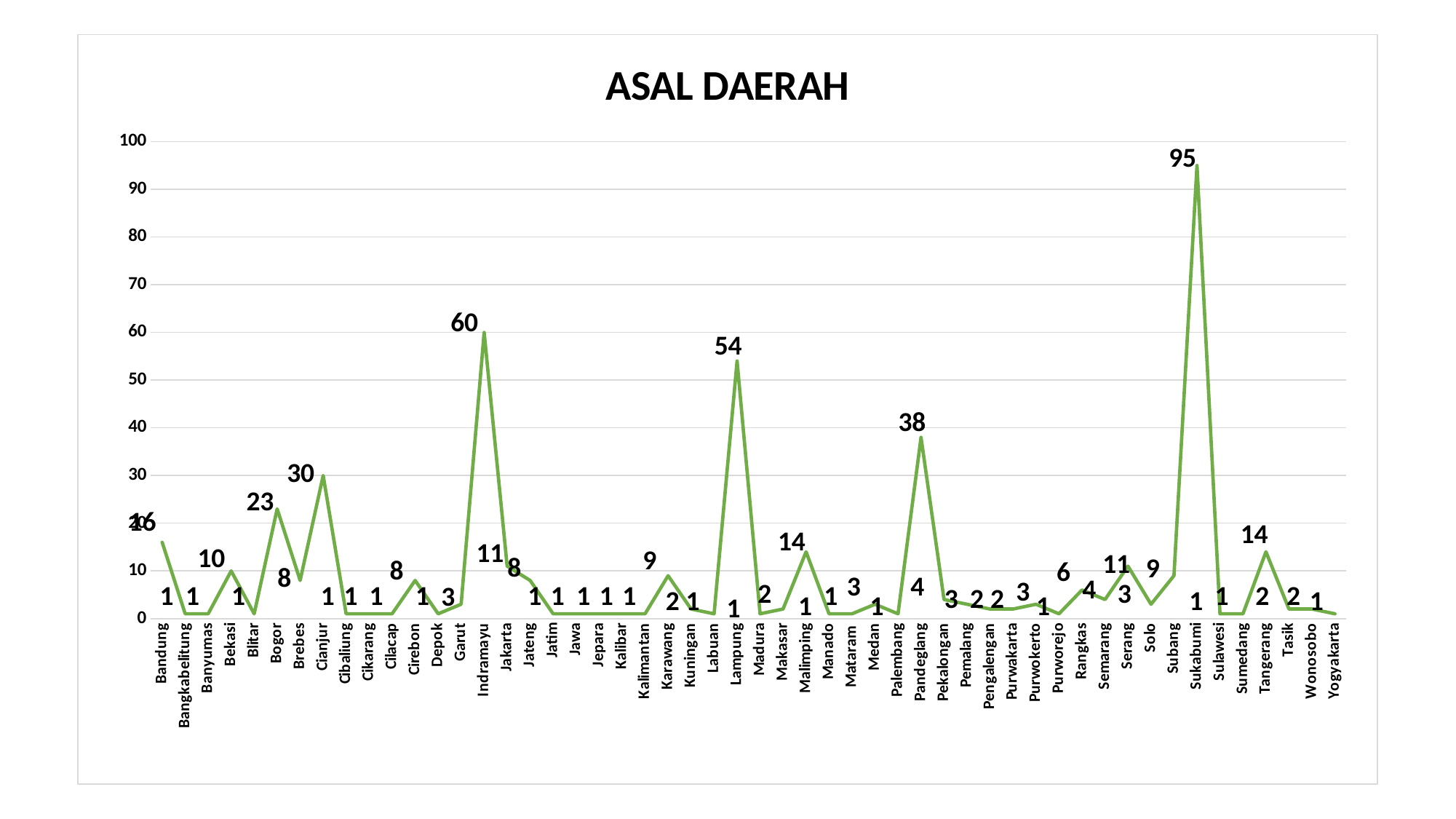
What is the value for Cianjur? 30 What is the value for Lampung? 54 Which region has the highest value? Sukabumi What kind of chart is shown on the slide? line chart Which has a larger value, Lampung or Pandeglang? Lampung What is the difference between the values for Sukabumi and Indramayu? 35 What is the title of the chart? ASAL DAERAH Is the value for Sukabumi greater or less than 90? greater How many regions are shown on the x axis? 52 What is the value for Pandeglang? 38 What is the value for Indramayu? 60 What is the value for Sukabumi? 95